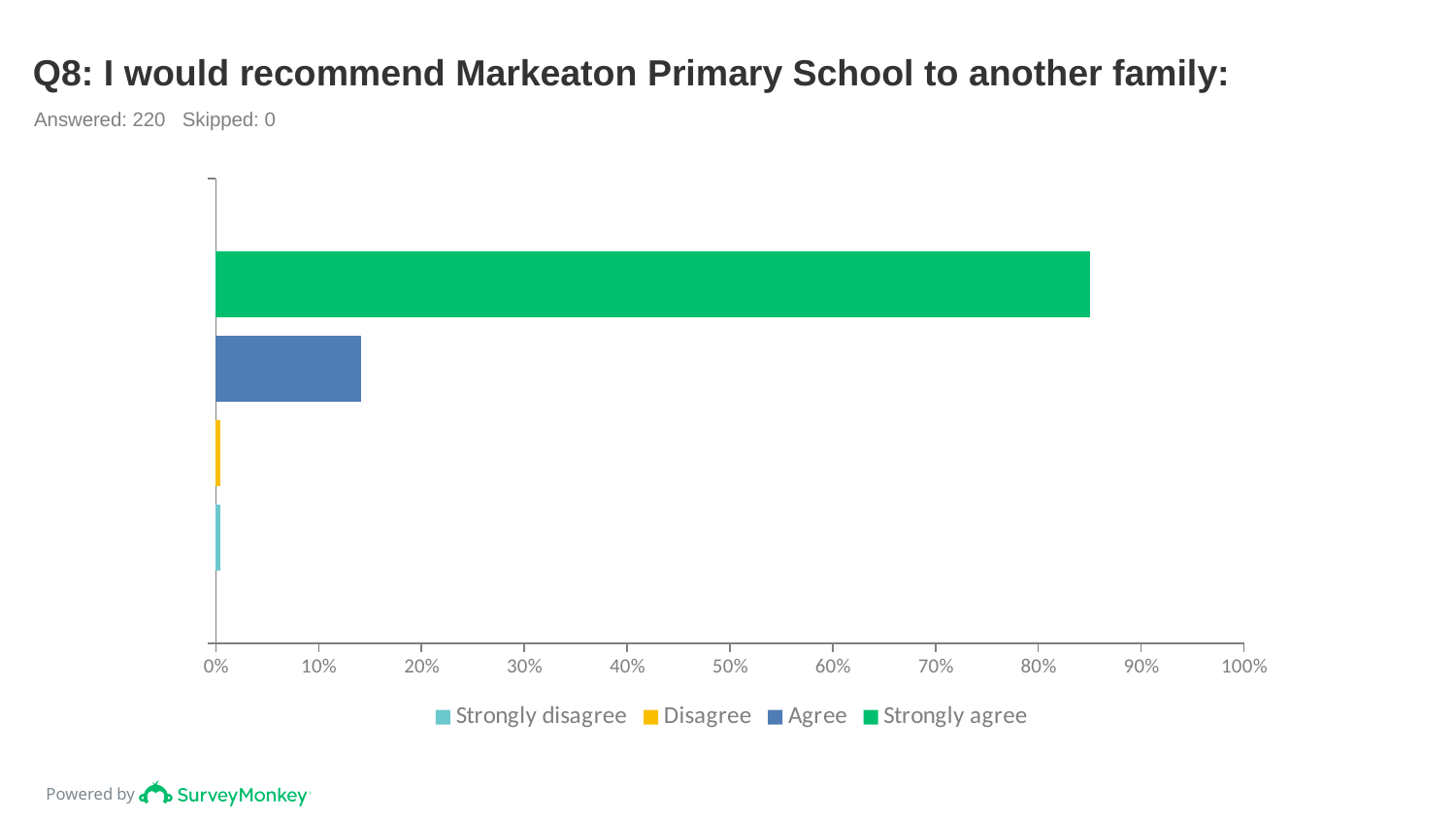
Is the value for Strongly agree greater or less than 80%? greater Which is larger, the value for Agree or the value for Strongly disagree? Agree Is the value for Agree greater or less than 10%? greater Is the value for Disagree greater or less than 10%? less Which response has the highest value? Strongly agree What kind of chart is shown on the slide? bar chart What is the title of the chart? Q8: I would recommend Markeaton Primary School to another family: Which legend entry is shown in green? Strongly agree How many series does the legend list? 4 Which is larger, the value for Strongly agree or the value for Agree? Strongly agree